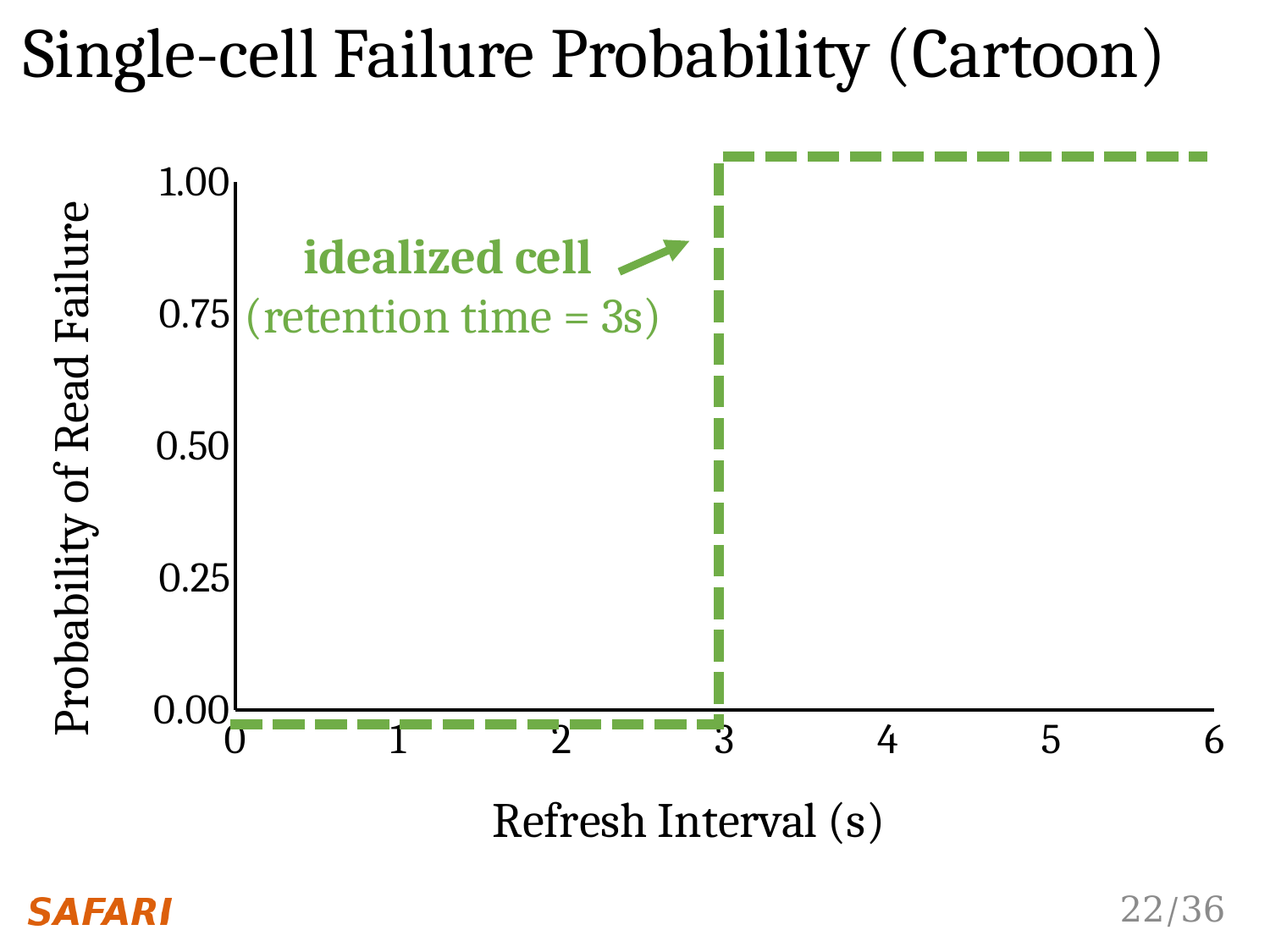
What is the title of the chart on the slide? Single-cell Failure Probability (Cartoon) What is the label of the x axis? Refresh Interval (s) What is the difference between the probability of read failure at 5 s and at 1 s? 1.00 What is the probability of read failure at a refresh interval of 1 s? 0.00 Which is larger, the probability of read failure at 2 s or at 4 s? 4 s At what refresh interval does the probability of read failure jump from 0.00 to 1.00? 3 What retention time is given for the idealized cell in the chart annotation? 3s Does the probability of read failure rise or fall as the refresh interval increases? rises What is the probability of read failure at a refresh interval of 5 s? 1.00 Is the probability of read failure at a refresh interval of 2 s greater or less than 0.50? less Is the probability of read failure at a refresh interval of 4 s greater or less than 0.50? greater What kind of chart is shown on the slide? line chart